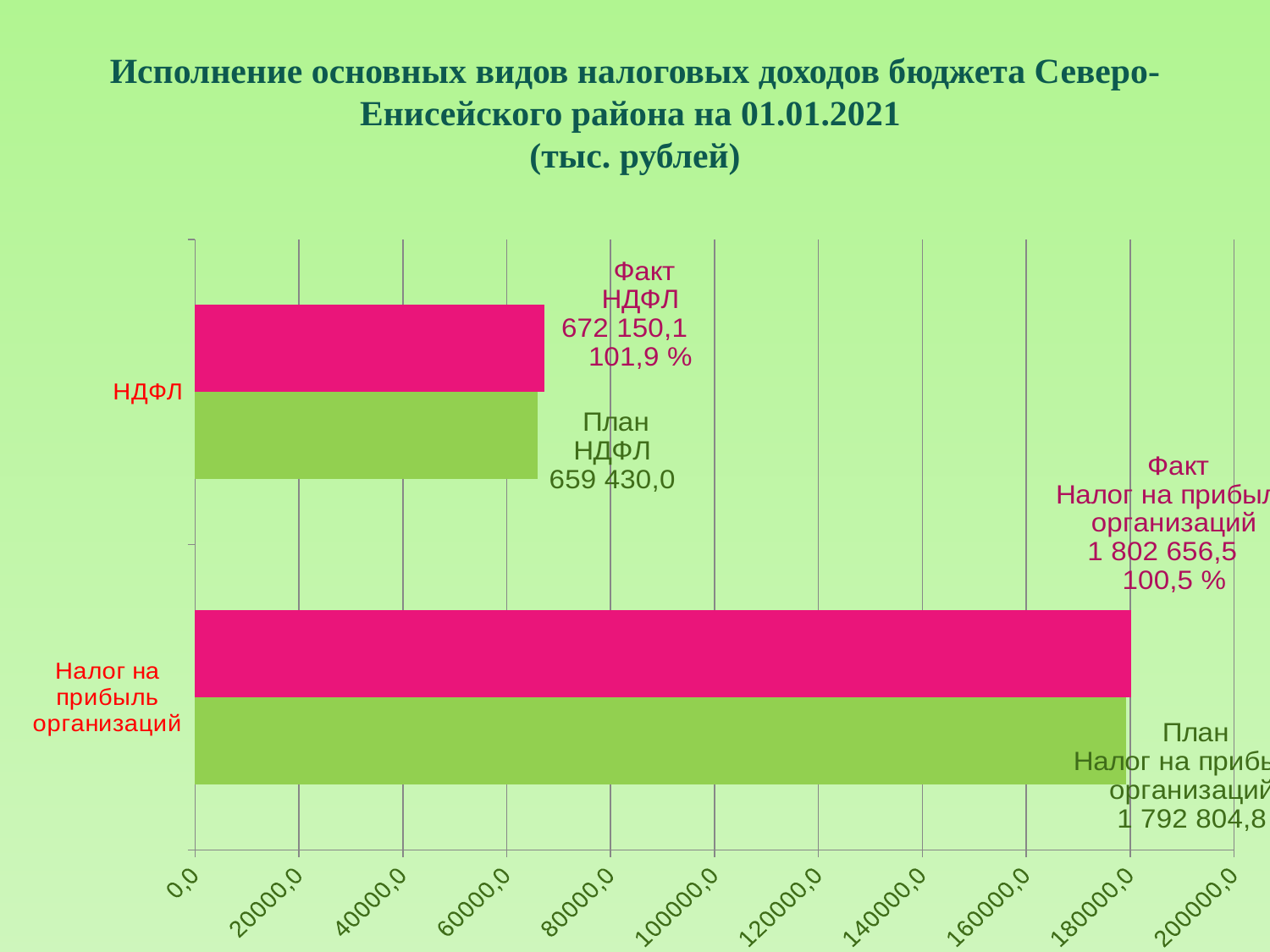
Which category has the lowest План value? НДФЛ What is the Факт value for НДФЛ? 672 150,1 Is the Факт bar for НДФЛ greater or less than 60000,0 on the axis? greater What percentage of plan execution is shown for Факт НДФЛ? 101,9 % Which is larger for Налог на прибыль организаций, the Факт value or the План value? Факт What is the План value for Налог на прибыль организаций? 1 792 804,8 What kind of chart is shown on the slide? Bar chart What is the План value for НДФЛ? 659 430,0 What percentage of plan execution is shown for Факт Налог на прибыль организаций? 100,5 % Which category has the highest Факт value? Налог на прибыль организаций What is the difference between the Факт and План values for НДФЛ? 12 720,1 What is the Факт value for Налог на прибыль организаций? 1 802 656,5